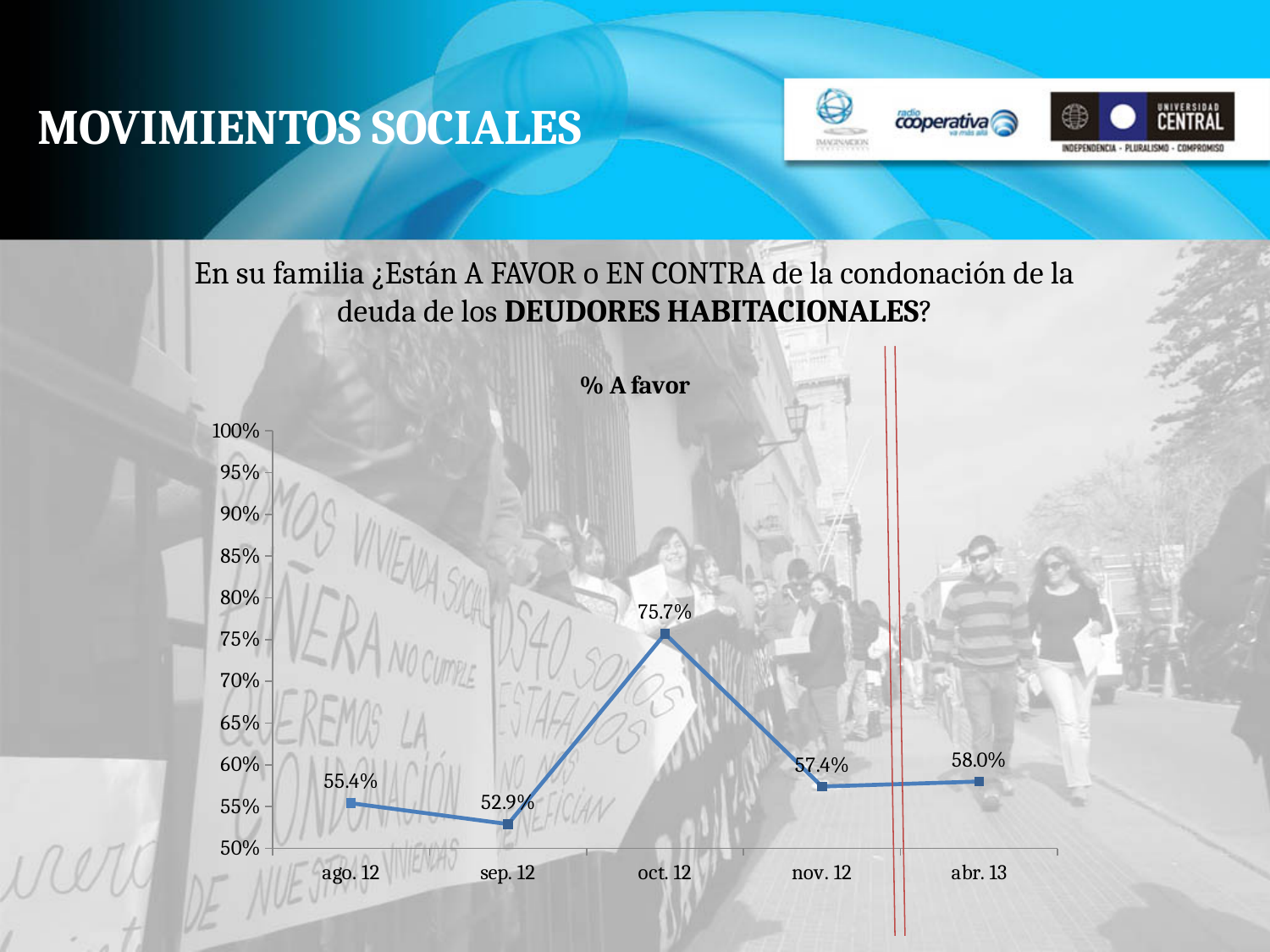
What is the value for ago. 12 in the '% A favor' chart? 55.4% Which is larger in the '% A favor' chart, the value for ago. 12 or the value for sep. 12? ago. 12 What is the title of the chart on the slide? % A favor How many data points are plotted in the '% A favor' chart? 5 Does the value rise or fall from sep. 12 to oct. 12 in the '% A favor' chart? rise What is the value for abr. 13 in the '% A favor' chart? 58.0% Is the value for oct. 12 in the '% A favor' chart greater or less than 70%? greater What is the value for oct. 12 in the '% A favor' chart? 75.7% What is the difference between the values for oct. 12 and nov. 12 in the '% A favor' chart? 18.3% Which month has the lowest value in the '% A favor' chart? sep. 12 Which month has the highest value in the '% A favor' chart? oct. 12 What kind of chart is the '% A favor' chart? line chart